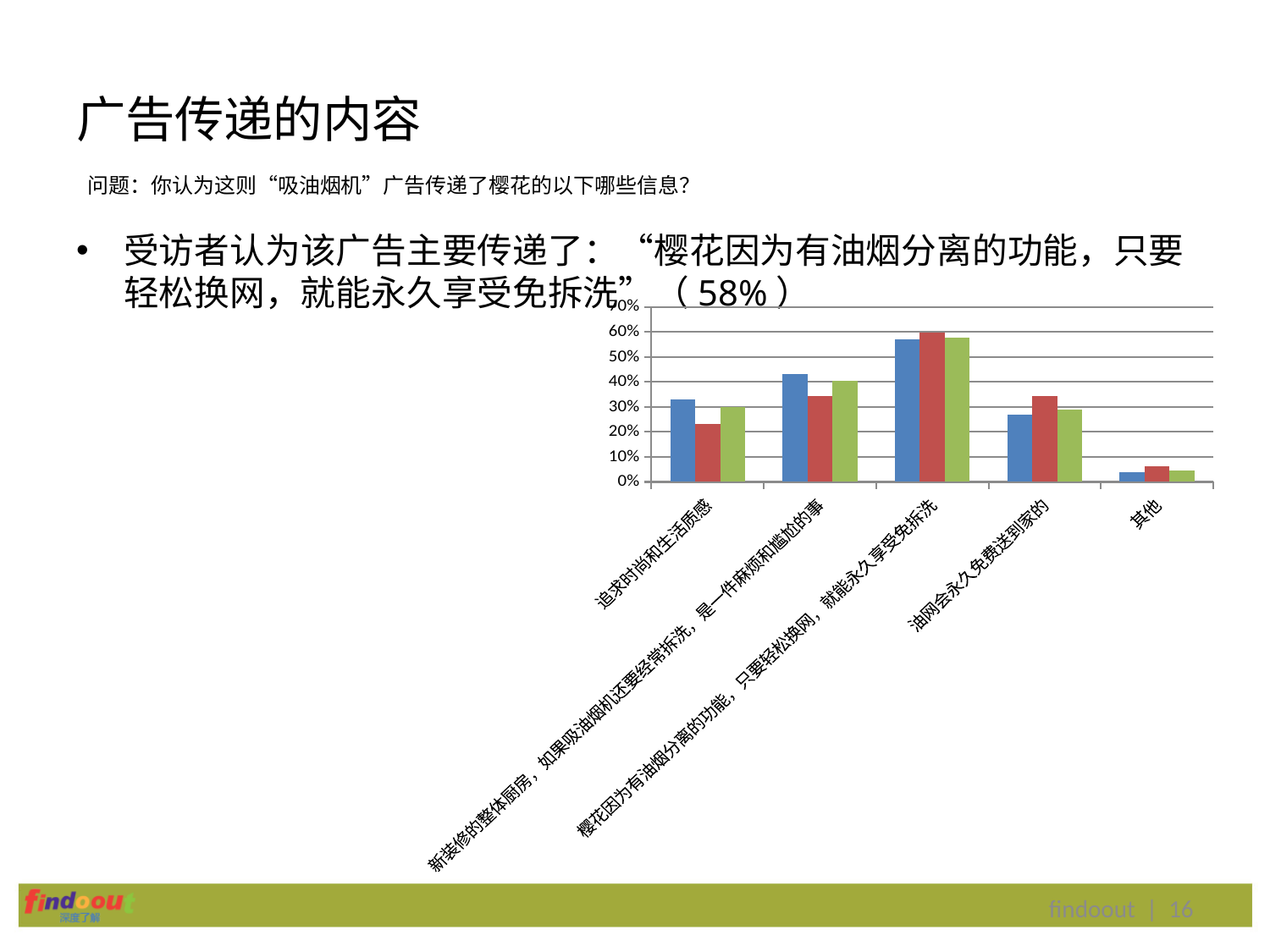
How many bars are plotted for each category in the chart? 3 Which has the larger blue bar: 新装修的整体厨房，如果吸油烟机还要经常拆洗，是一件麻烦和尴尬的事 or 油网会永久免费送到家的? 新装修的整体厨房，如果吸油烟机还要经常拆洗，是一件麻烦和尴尬的事 Is the value of the blue bar for 油网会永久免费送到家的 greater or less than 40%? less What kind of chart is shown on the slide? bar chart Which category has the shortest bars in the chart? 其他 Is the value of the green bar for 新装修的整体厨房，如果吸油烟机还要经常拆洗，是一件麻烦和尴尬的事 greater or less than 30%? greater Is the value of the blue bar for 追求时尚和生活质感 greater or less than 20%? greater Which category has the tallest bars in the chart? 樱花因为有油烟分离的功能，只要轻松换网，就能永久享受免拆洗 How many categories are shown on the x axis of the chart? 5 What is the highest value shown on the chart's vertical axis? 70%